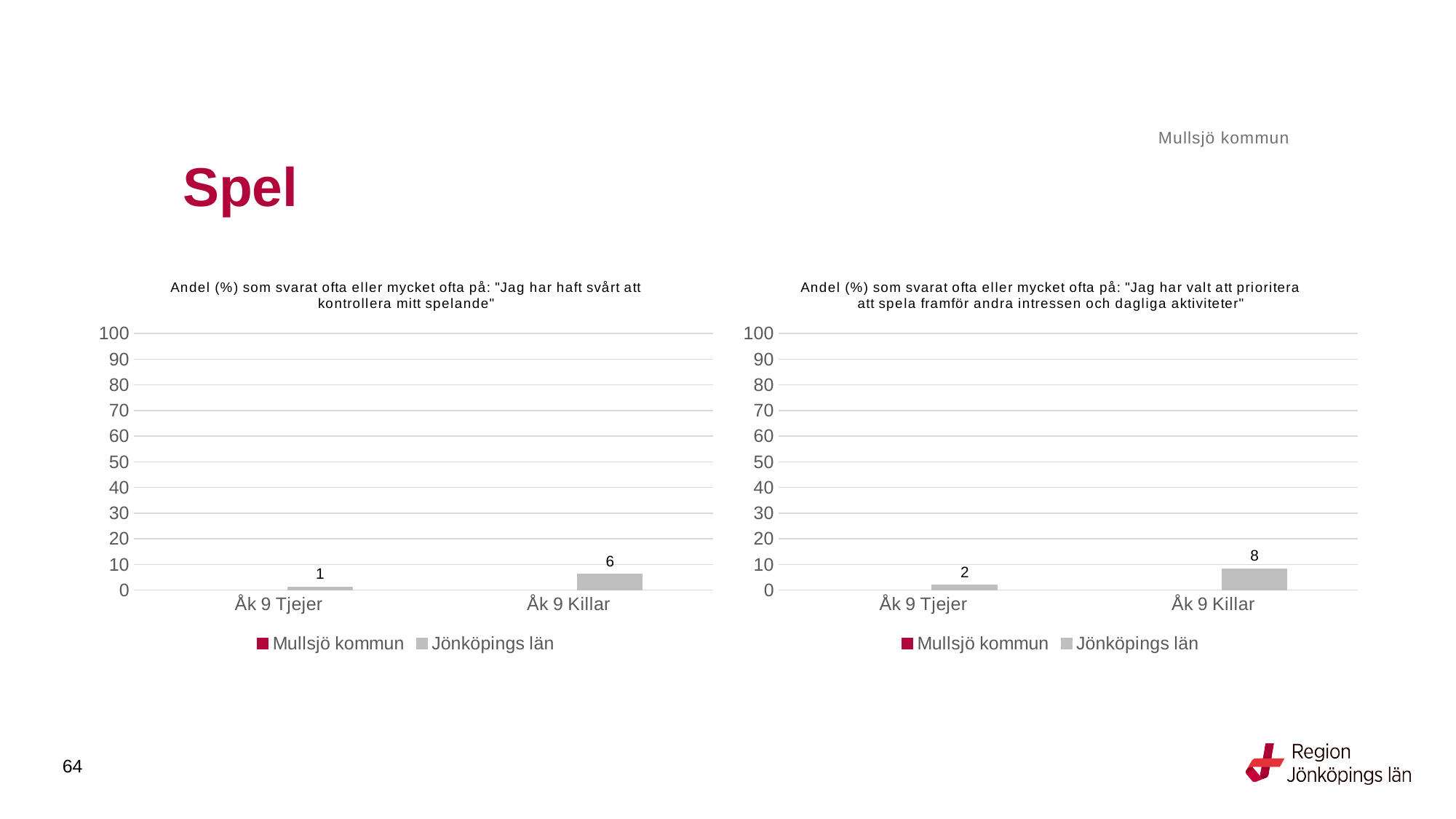
In the left chart, what is the difference between the Jönköpings län values for Åk 9 Killar and Åk 9 Tjejer? 5 What kind of chart is the left chart? Bar chart In the right chart, is the Jönköpings län value for Åk 9 Killar greater or less than 10? less In the left chart ("Jag har haft svårt att kontrollera mitt spelande"), what is the value for Jönköpings län for Åk 9 Killar? 6 In the left chart ("Jag har haft svårt att kontrollera mitt spelande"), what is the value for Jönköpings län for Åk 9 Tjejer? 1 In the right chart ("Jag har valt att prioritera att spela framför andra intressen och dagliga aktiviteter"), what is the value for Jönköpings län for Åk 9 Killar? 8 In the left chart, which category has the higher Jönköpings län value, Åk 9 Tjejer or Åk 9 Killar? Åk 9 Killar How many categories are shown on the x axis of the left chart? 2 In the right chart, which category has the lowest Jönköpings län value? Åk 9 Tjejer In the right chart ("Jag har valt att prioritera att spela framför andra intressen och dagliga aktiviteter"), what is the value for Jönköpings län for Åk 9 Tjejer? 2 In the right chart, what is the difference between the Jönköpings län values for Åk 9 Killar and Åk 9 Tjejer? 6 How many series does the legend of the right chart list? 2